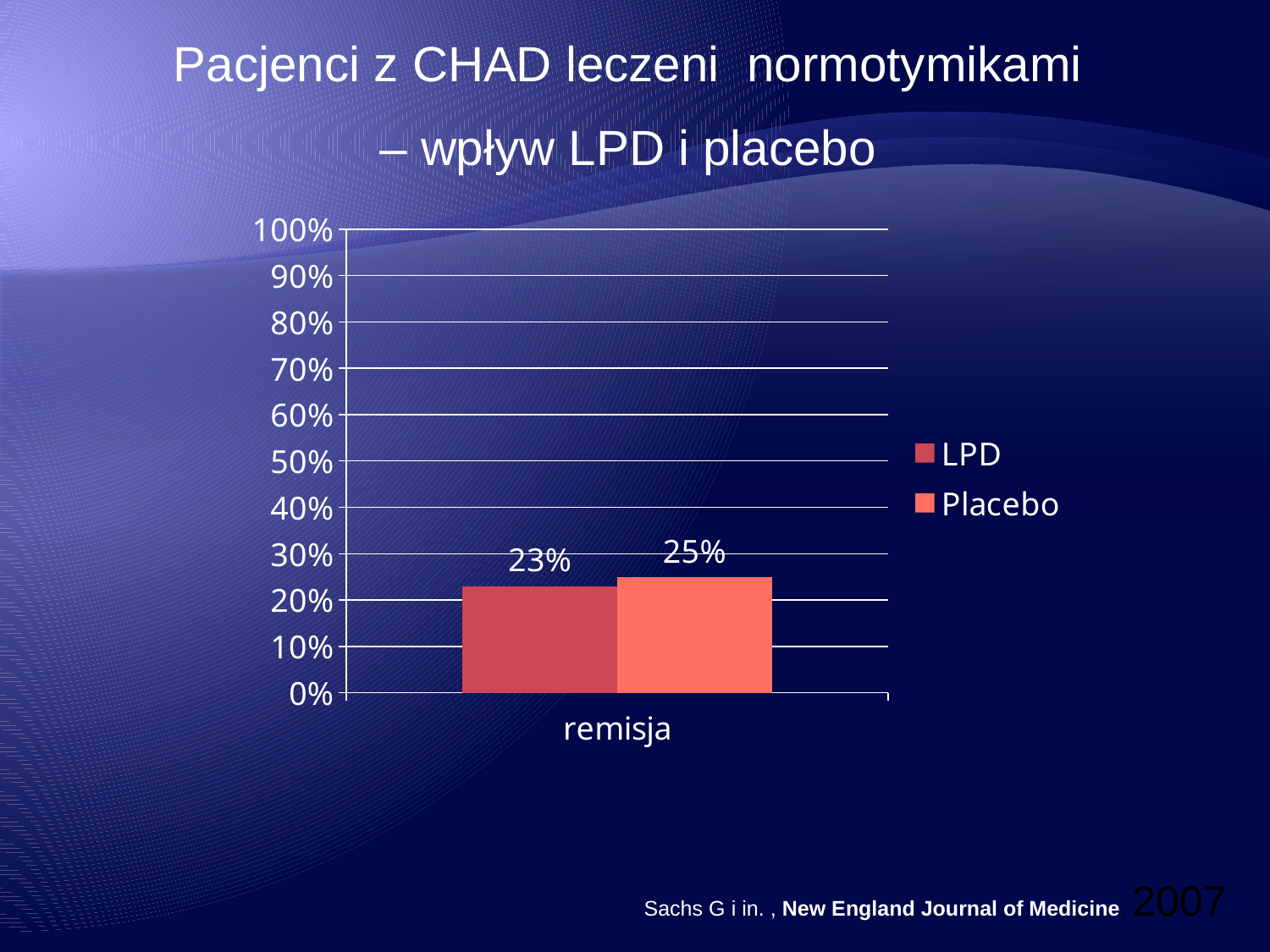
Which series has the lowest value in the chart? LPD What is the label of the category on the x axis? remisja How many categories are shown on the x axis? 1 Is the value for LPD greater or less than 20%? greater What is the value for LPD in the remisja category? 23% How many series does the legend list? 2 What kind of chart is shown on the slide? bar chart What is the difference between the Placebo and LPD values for remisja? 2% What is the value for Placebo in the remisja category? 25% What is the maximum value shown on the y axis? 100% Is the value for Placebo greater or less than 30%? less Which series has the higher value for remisja, LPD or Placebo? Placebo